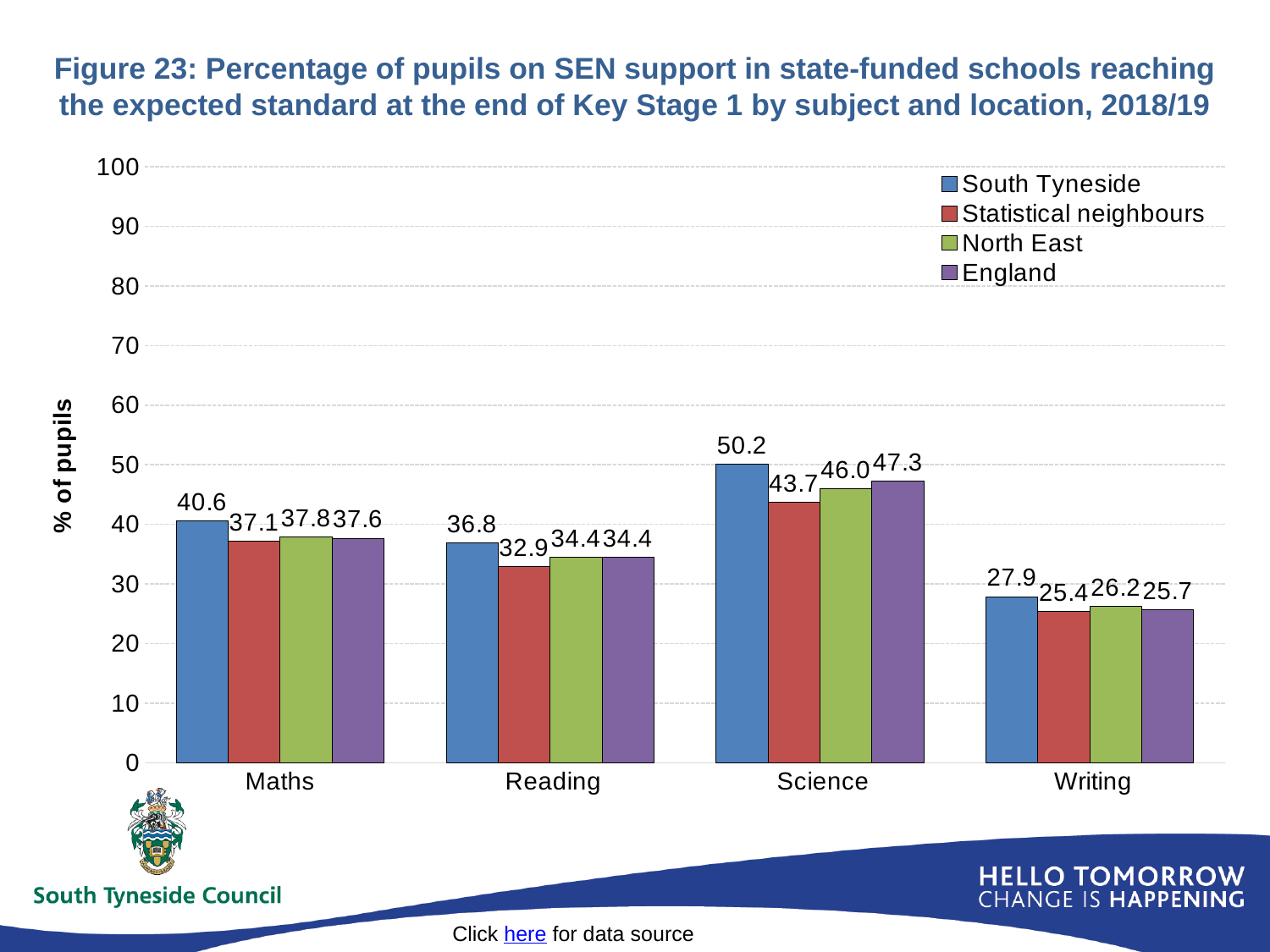
Which is larger in Maths: South Tyneside or England? South Tyneside What is the value for South Tyneside in Science? 50.2 How many subjects are shown on the x axis? 4 What is the value for Statistical neighbours in Reading? 32.9 What is the value for England in Writing? 25.7 Which subject has the lowest value for England? Writing What is the difference between South Tyneside and Statistical neighbours in Science? 6.5 How many series does the legend list? 4 What is the label of the y axis? % of pupils Which subject has the highest value for South Tyneside? Science What is the value for North East in Maths? 37.8 What kind of chart is shown on the slide? Bar chart